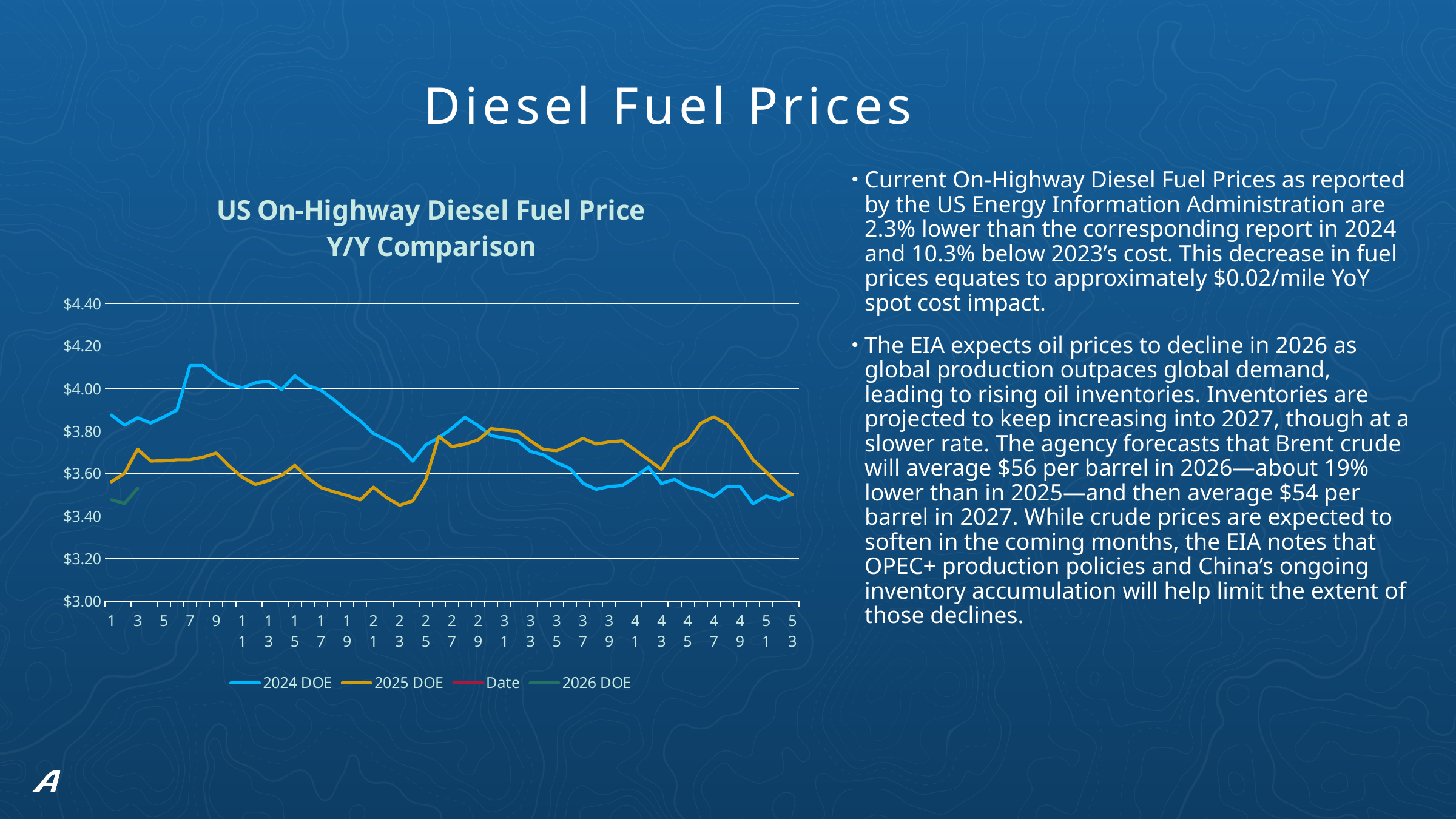
Is the 2025 DOE value at week 23 greater or less than $3.60? less What is the title of the chart? US On-Highway Diesel Fuel Price Y/Y Comparison Is the 2024 DOE value at week 7 greater or less than $4.00? greater At week 47, which series has the higher value, 2024 DOE or 2025 DOE? 2025 DOE Does the 2024 DOE line rise or fall between week 7 and week 23? Fall Is the 2026 DOE value at week 1 greater or less than $3.60? less Which series are listed in the chart's legend? 2024 DOE, 2025 DOE, Date, 2026 DOE How many series does the legend of the chart list? 4 At week 1, which series has the higher value, 2024 DOE or 2025 DOE? 2024 DOE What kind of chart is shown on the slide? Line chart Which series reaches the highest value anywhere on the chart? 2024 DOE